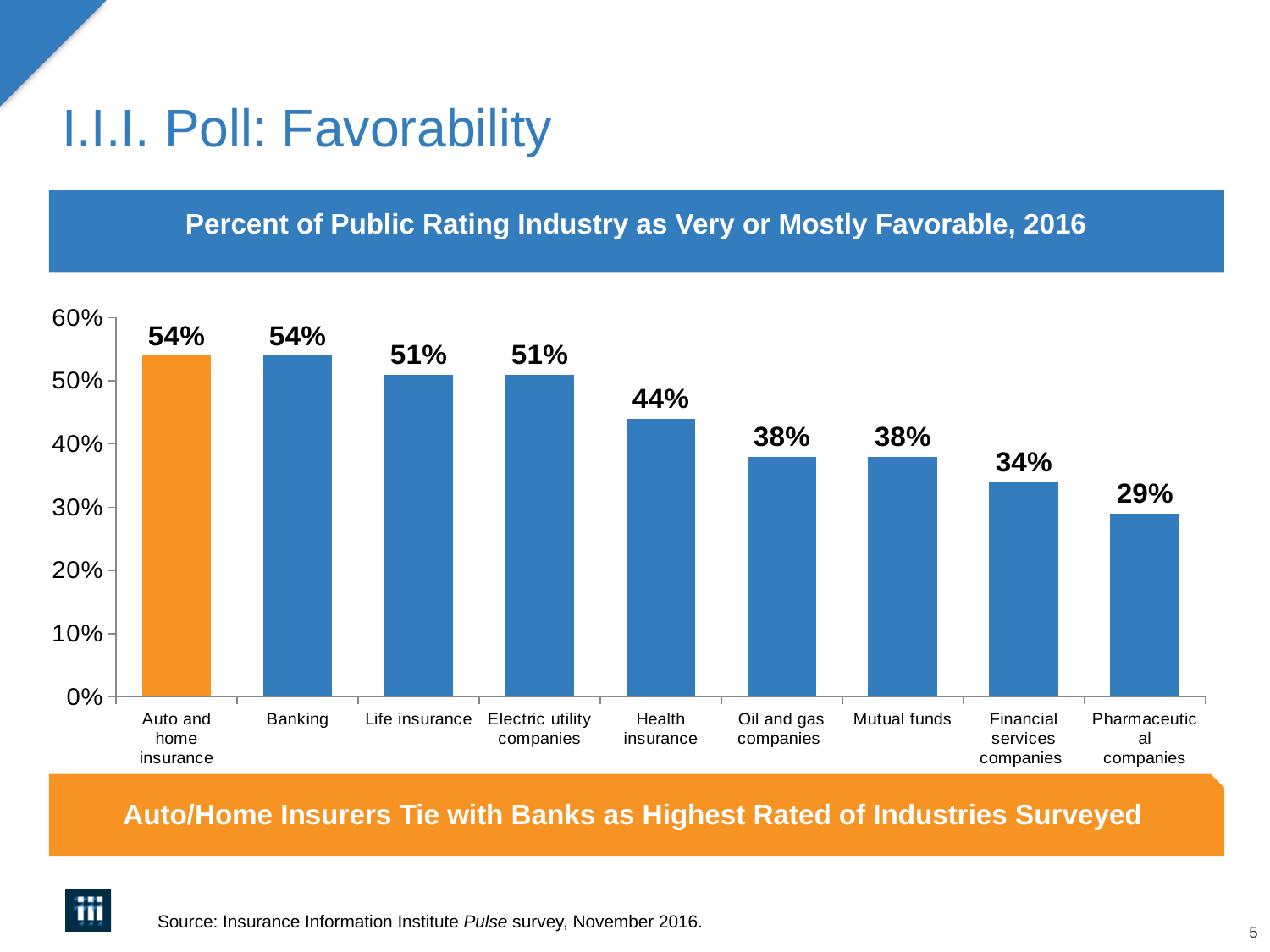
What percent of the public rated the health insurance industry as very or mostly favorable? 44% What is the difference between the values for life insurance and health insurance? 7% What is the value shown for pharmaceutical companies? 29% What is the value shown for financial services companies? 34% What is the difference between the favorability rating for banking and for pharmaceutical companies? 25% Which industry has the lowest favorability rating in the chart? Pharmaceutical companies Which is larger, the value for oil and gas companies or the value for financial services companies? Oil and gas companies Do the values rise or fall moving from left to right across the chart? Fall Which bar is highlighted in orange? Auto and home insurance Is the value for mutual funds greater or less than 40%? less How many industries are shown in the chart? 9 What kind of chart is shown on the slide? Bar chart